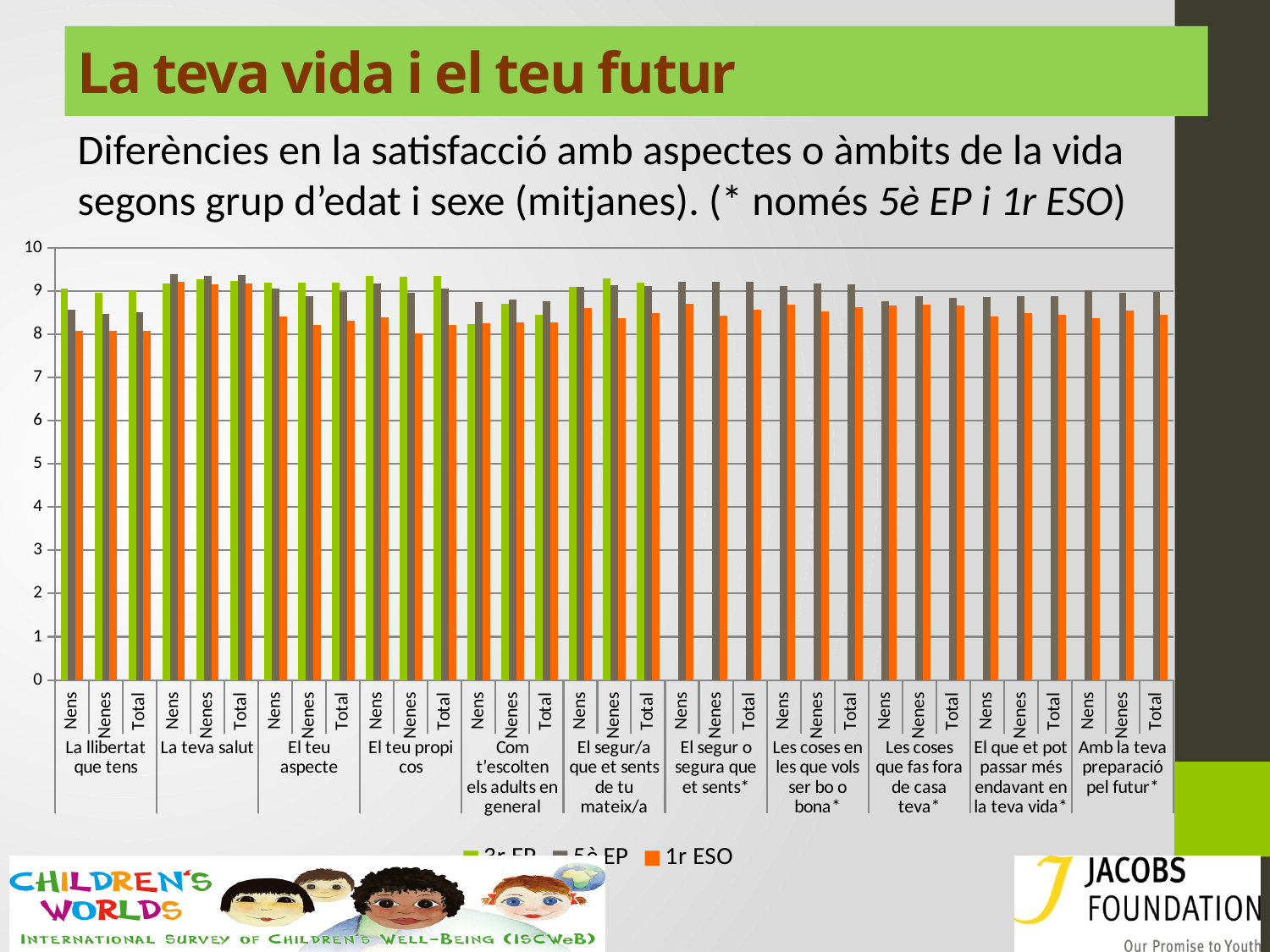
Which series is absent for the aspects marked with an asterisk (*), such as 'El segur o segura que et sents*'? 3r EP Is the 1r ESO value for Nens in 'La teva salut' greater or less than 9? greater Is the 5è EP value for Nens in 'La llibertat que tens' greater or less than 9? less What kind of chart is shown on the slide? bar chart What is the highest value shown on the chart's vertical axis? 10 How many life aspects (category groups) are shown along the x axis of the chart? 11 Is the 1r ESO value for Nenes in 'El teu aspecte' greater or less than 9? less How many series does the chart's legend list? 3 For Nens in 'El segur/a que et sents de tu mateix/a', which is larger: the 5è EP value or the 1r ESO value? 5è EP For Nens in 'La llibertat que tens', which is larger: the 3r EP value or the 1r ESO value? 3r EP